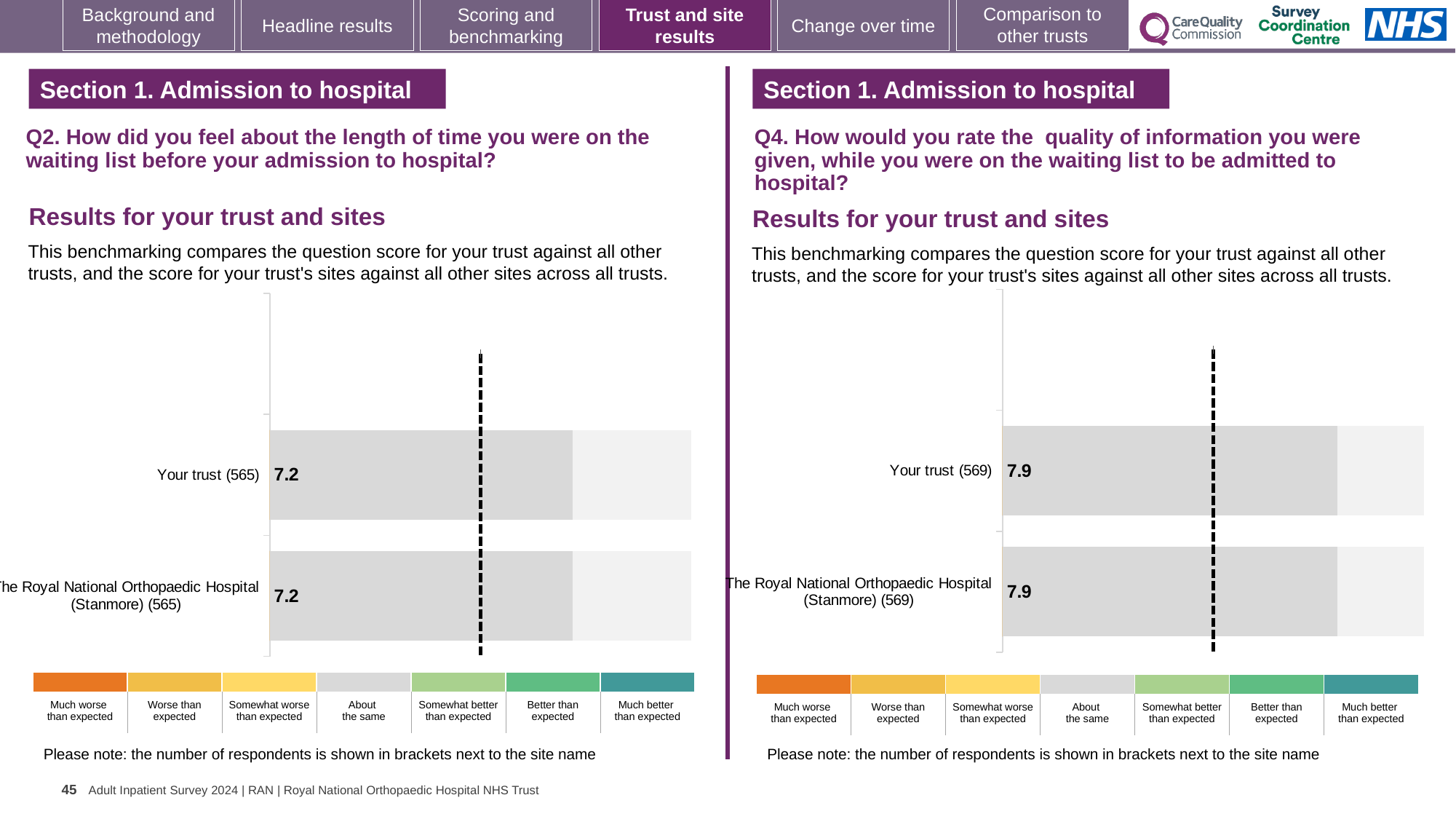
How many bars are plotted in the Q2 chart on the left? 2 In the Q4 chart on the right, what is the score for The Royal National Orthopaedic Hospital (Stanmore)? 7.9 In the Q4 chart on the right, what is the score for Your trust? 7.9 What kind of chart is the Q2 chart on the left? Bar chart In the Q4 chart on the right, how many respondents are shown in brackets for The Royal National Orthopaedic Hospital (Stanmore)? 569 In the Q4 chart on the right, what is the difference between the score for Your trust and the score for The Royal National Orthopaedic Hospital (Stanmore)? 0 In the Q2 chart on the left, what is the difference between the score for Your trust and the score for The Royal National Orthopaedic Hospital (Stanmore)? 0 In the Q2 chart on the left, how many respondents are shown in brackets for Your trust? 565 How many bars are plotted in the Q4 chart on the right? 2 In the Q2 chart on the left, what is the score for Your trust? 7.2 In the Q2 chart on the left, what is the score for The Royal National Orthopaedic Hospital (Stanmore)? 7.2